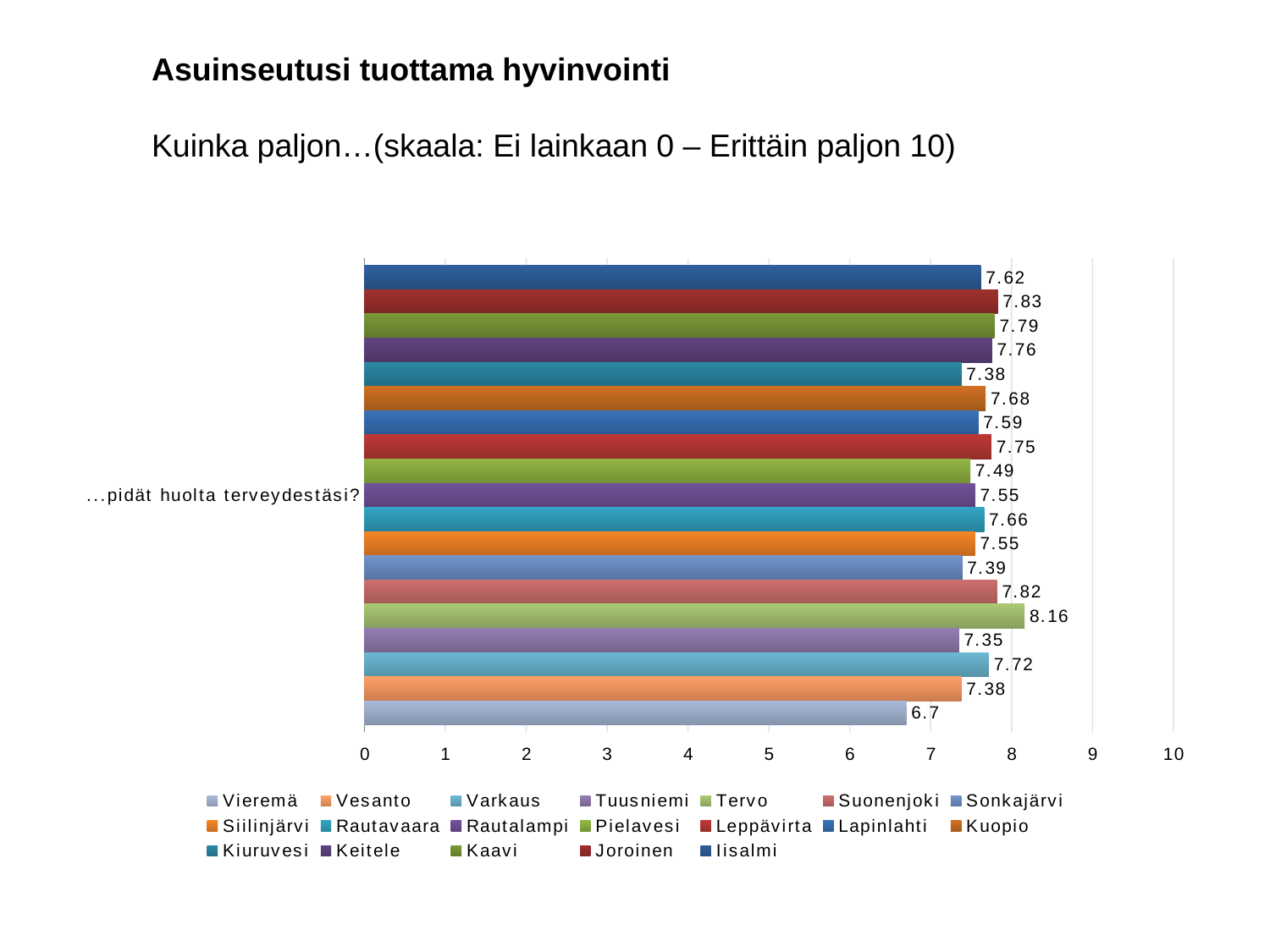
Which is larger, the value for Suonenjoki or the value for Tuusniemi? Suonenjoki What is the value for Vieremä? 6.7 Is the value for Vieremä greater or less than 7? less What kind of chart is shown on the slide? bar chart What is the value for Tervo? 8.16 What is the value for Joroinen? 7.83 How many series does the legend list? 19 Which municipality has the lowest value? Vieremä What is the difference between the values for Tervo and Vieremä? 1.46 What is the category label shown on the vertical axis? ...pidät huolta terveydestäsi? What is the value for Kuopio? 7.68 Which municipality has the highest value? Tervo